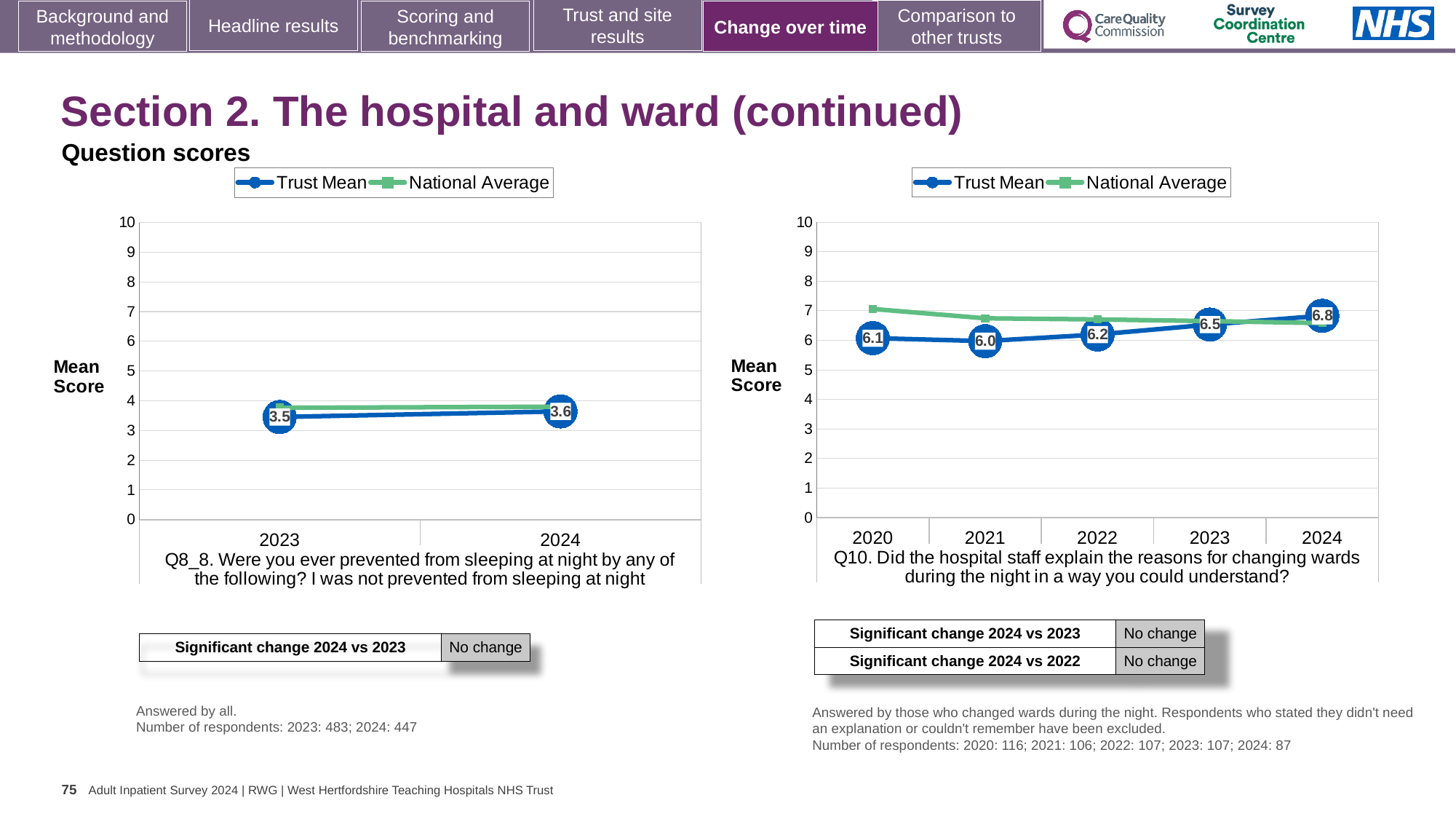
In the Q8_8 chart on the left, what is the Trust Mean score for 2023? 3.5 In the Q10 chart on the right, which year has the highest Trust Mean score? 2024 In the Q10 chart on the right, is the Trust Mean score higher in 2023 or in 2022? 2023 In the Q8_8 chart on the left, what is the Trust Mean score for 2024? 3.6 How many series does the legend of the Q8_8 chart on the left list? 2 What type of chart is the Q10 chart on the right? Line chart How many years are plotted on the x axis of the Q10 chart on the right? 5 In the Q10 chart on the right, what is the Trust Mean score for 2024? 6.8 In the Q10 chart on the right, what is the Trust Mean score for 2021? 6.0 In the Q10 chart on the right, which year has the lowest Trust Mean score? 2021 In the Q10 chart on the right, is the National Average for 2020 greater or less than 6? greater In the Q10 chart on the right, what is the difference between the Trust Mean scores for 2024 and 2020? 0.7